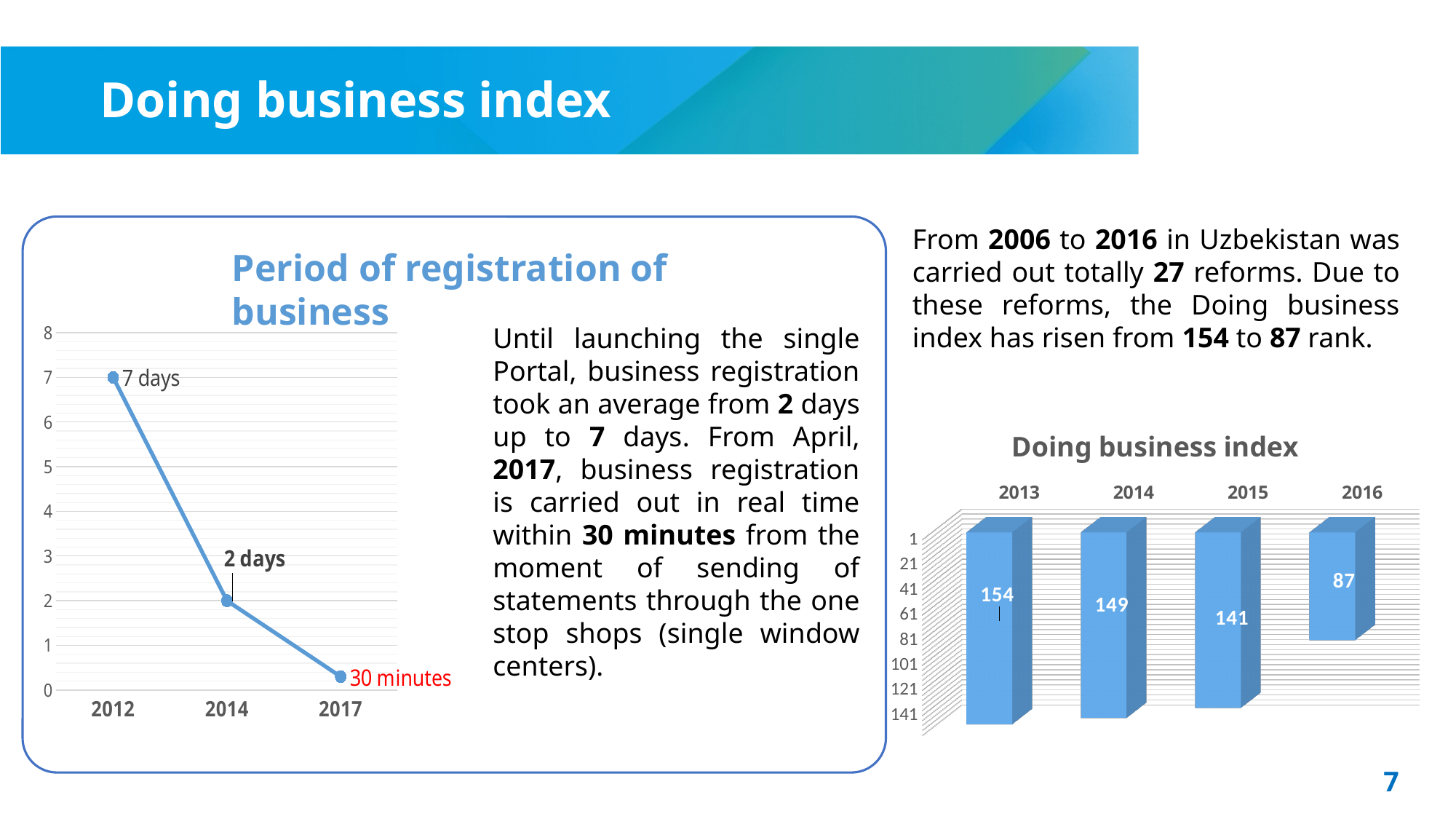
In the 'Period of registration of business' chart, what is the data label for 2017? 30 minutes In the 'Period of registration of business' chart, what is the data label for 2012? 7 days In the 'Period of registration of business' chart, do the values rise or fall from 2012 to 2017? Fall In the 'Doing business index' chart, what is the value for 2016? 87 In the 'Doing business index' chart, how many years are shown? 4 In the 'Doing business index' chart, what is the difference between the values for 2013 and 2016? 67 In the 'Doing business index' chart, which year has the lowest value? 2016 In the 'Doing business index' chart, what is the value for 2015? 141 What kind of chart is the 'Period of registration of business' chart? Line chart In the 'Doing business index' chart, what is the value for 2013? 154 What kind of chart is the 'Doing business index' chart? Bar chart In the 'Doing business index' chart, which year has the highest value? 2013